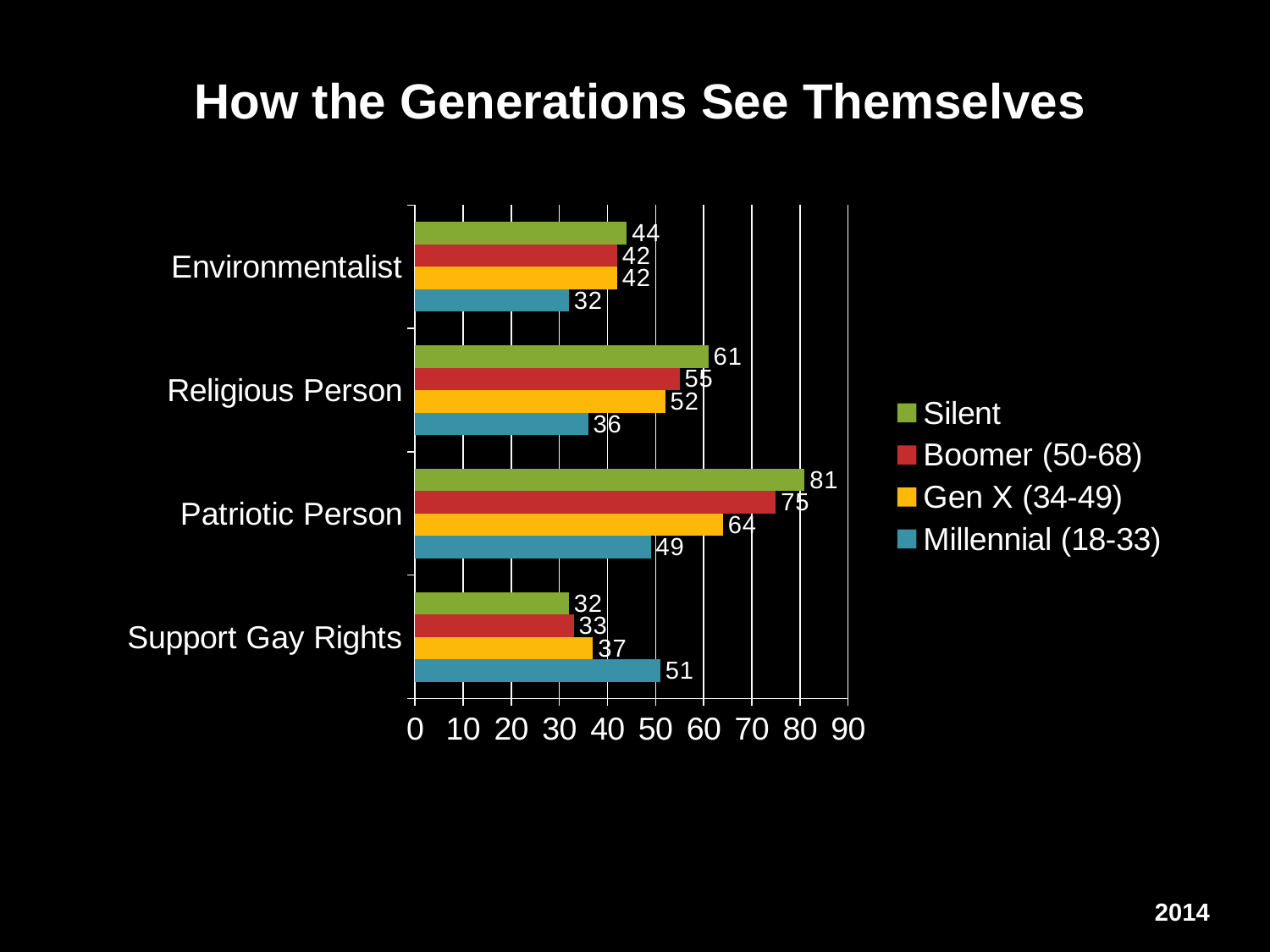
What is the difference between the Silent and Millennial (18-33) values in the Patriotic Person category? 32 What is the title of the chart? How the Generations See Themselves What is the value for Millennial (18-33) in the Support Gay Rights category? 51 Which generation has the highest value in the Support Gay Rights category? Millennial (18-33) What is the value for Silent in the Patriotic Person category? 81 What is the value for Gen X (34-49) in the Religious Person category? 52 How many series does the legend list? 4 Which generation has the lowest value in the Environmentalist category? Millennial (18-33) Which is larger: the Boomer (50-68) value for Religious Person or the Boomer (50-68) value for Environmentalist? Religious Person What kind of chart is shown on the slide? Bar chart How many categories are shown on the chart? 4 Is the value for Gen X (34-49) in the Patriotic Person category greater or less than 60? greater